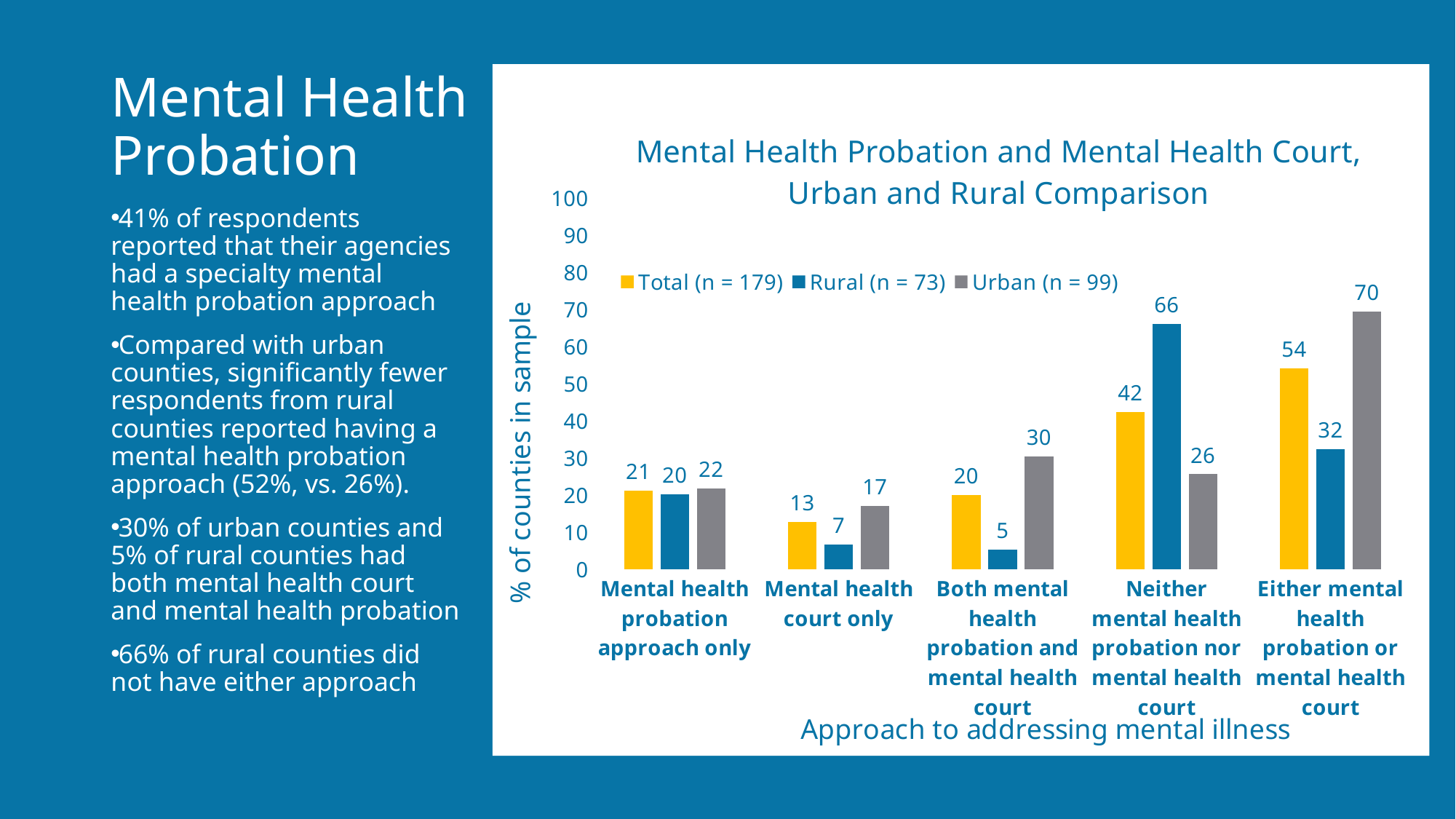
What is the title of the chart? Mental Health Probation and Mental Health Court, Urban and Rural Comparison Which is larger for 'Neither mental health probation nor mental health court': the Rural value or the Urban value? Rural What is the Urban value for 'Either mental health probation or mental health court'? 70 What is the difference between the Urban and Rural values for 'Both mental health probation and mental health court'? 25 What is the Total value for 'Mental health court only'? 13 What is the label of the y axis? % of counties in sample How many series does the legend list? 3 Which category has the lowest Rural value? Both mental health probation and mental health court What is the Rural value for 'Neither mental health probation nor mental health court'? 66 How many categories are shown on the x axis? 5 What kind of chart is shown on the slide? Bar chart Which category has the highest Urban value? Either mental health probation or mental health court